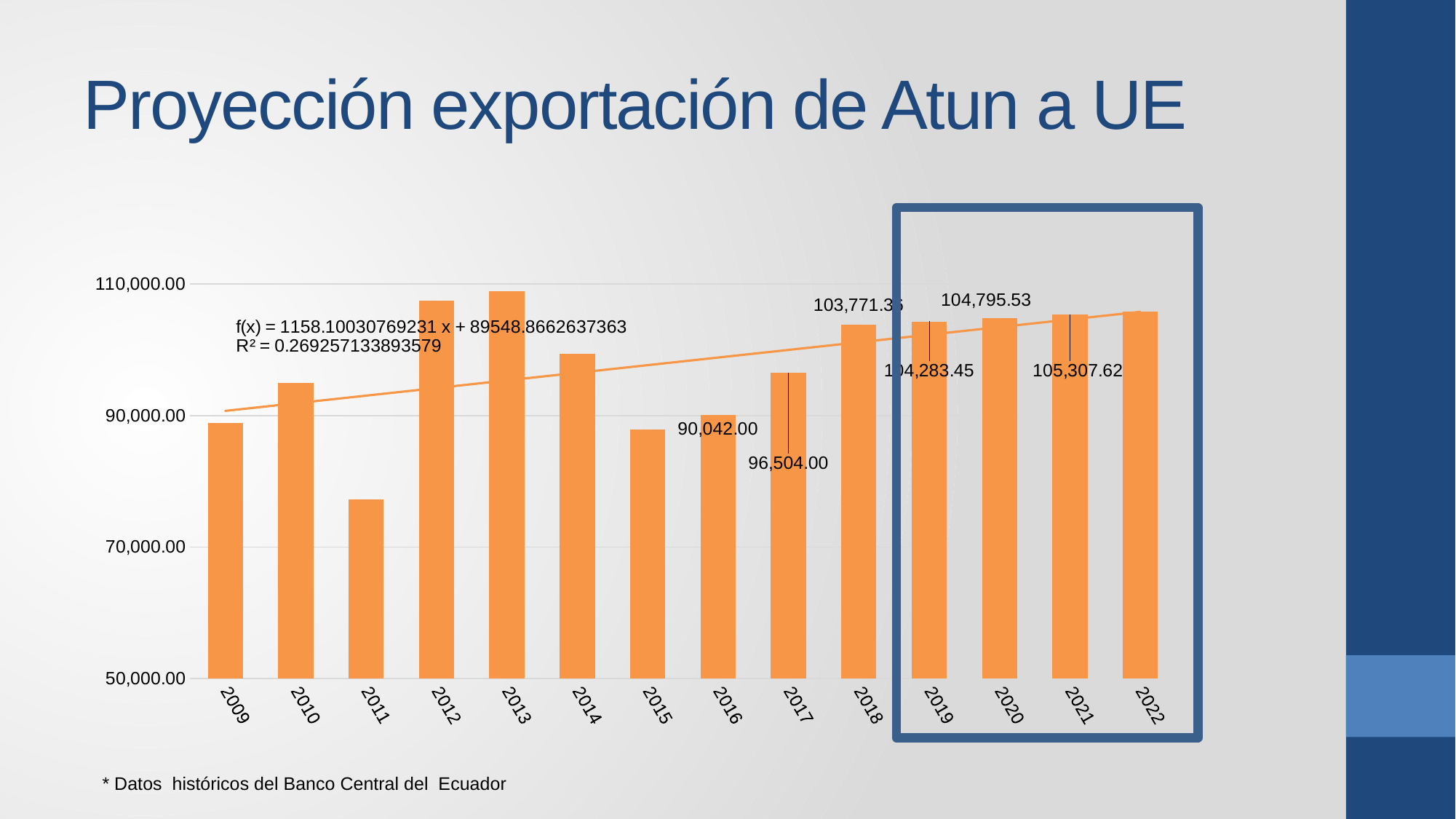
What is the value for 2019? 104,283.45 How many years are shown on the x axis? 14 What is the value for 2017? 96,504.00 What is the R² value shown for the trendline? 0.269257133893579 Which year has the highest bar? 2013 What is the difference between the values for 2021 and 2020? 512.09 Which is larger, the value for 2019 or the value for 2021? 2021 Which year has the lowest bar? 2011 Is the value for 2011 greater or less than 90,000.00? less What is the value for 2021? 105,307.62 What is the difference between the values for 2017 and 2016? 6,462.00 What is the value for 2016? 90,042.00